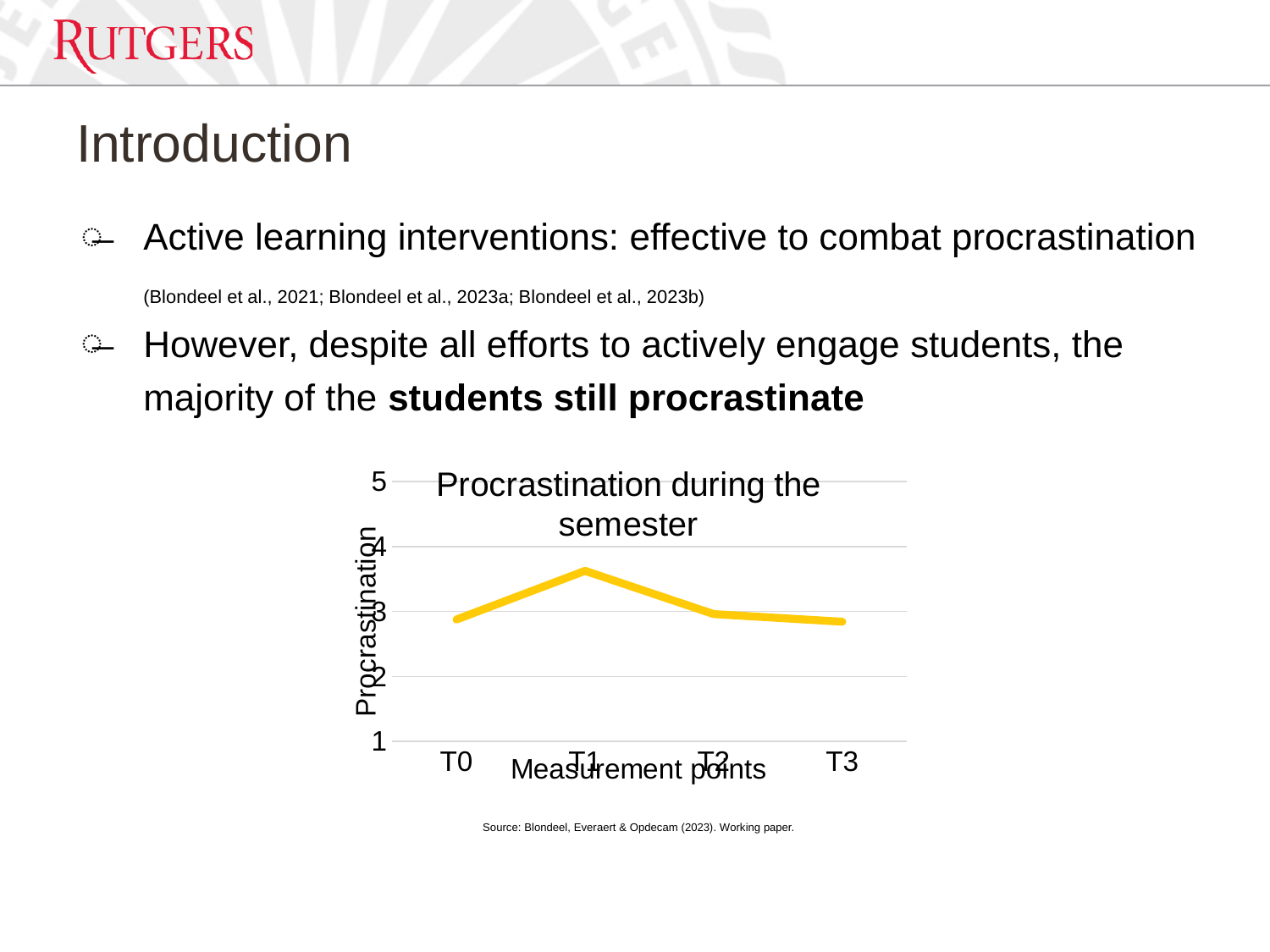
What is the title of the chart? Procrastination during the semester Is the procrastination value at T1 greater or less than 3? greater What is the label of the x axis of the chart? Measurement points Is the procrastination value at T0 greater or less than 4? less Is the procrastination value at T3 greater or less than 2? greater Does procrastination rise or fall from T1 to T2? fall What kind of chart is shown on the slide? line chart How many measurement points are plotted on the x axis of the chart? 4 Which is larger, the procrastination value at T1 or at T3? T1 Does procrastination rise or fall from T0 to T1? rise At which measurement point is procrastination highest? T1